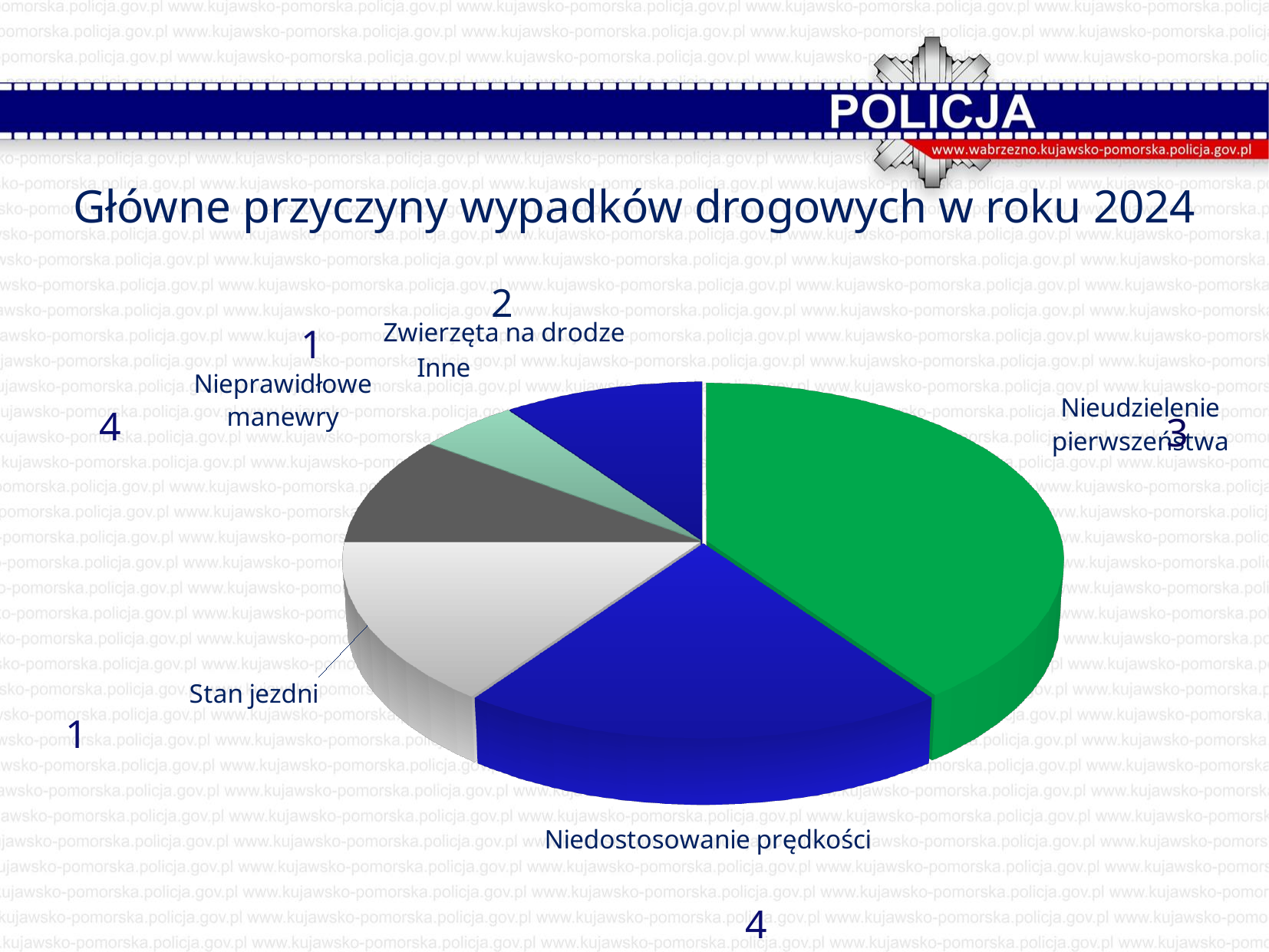
What is the title of the chart? Główne przyczyny wypadków drogowych w roku 2024 Which category has the largest slice of the pie? Nieudzielenie pierwszeństwa Which category is shown in green on the pie chart? Nieudzielenie pierwszeństwa Which slice is larger: Niedostosowanie prędkości or Zwierzęta na drodze? Niedostosowanie prędkości What kind of chart is shown on the slide? pie chart Which slice is larger: Nieudzielenie pierwszeństwa or Niedostosowanie prędkości? Nieudzielenie pierwszeństwa Which year does the chart refer to? 2024 How many categories (slices) does the pie chart have? 6 Which category has the smallest slice of the pie? Zwierzęta na drodze Which slice is larger: Stan jezdni or Inne? Stan jezdni